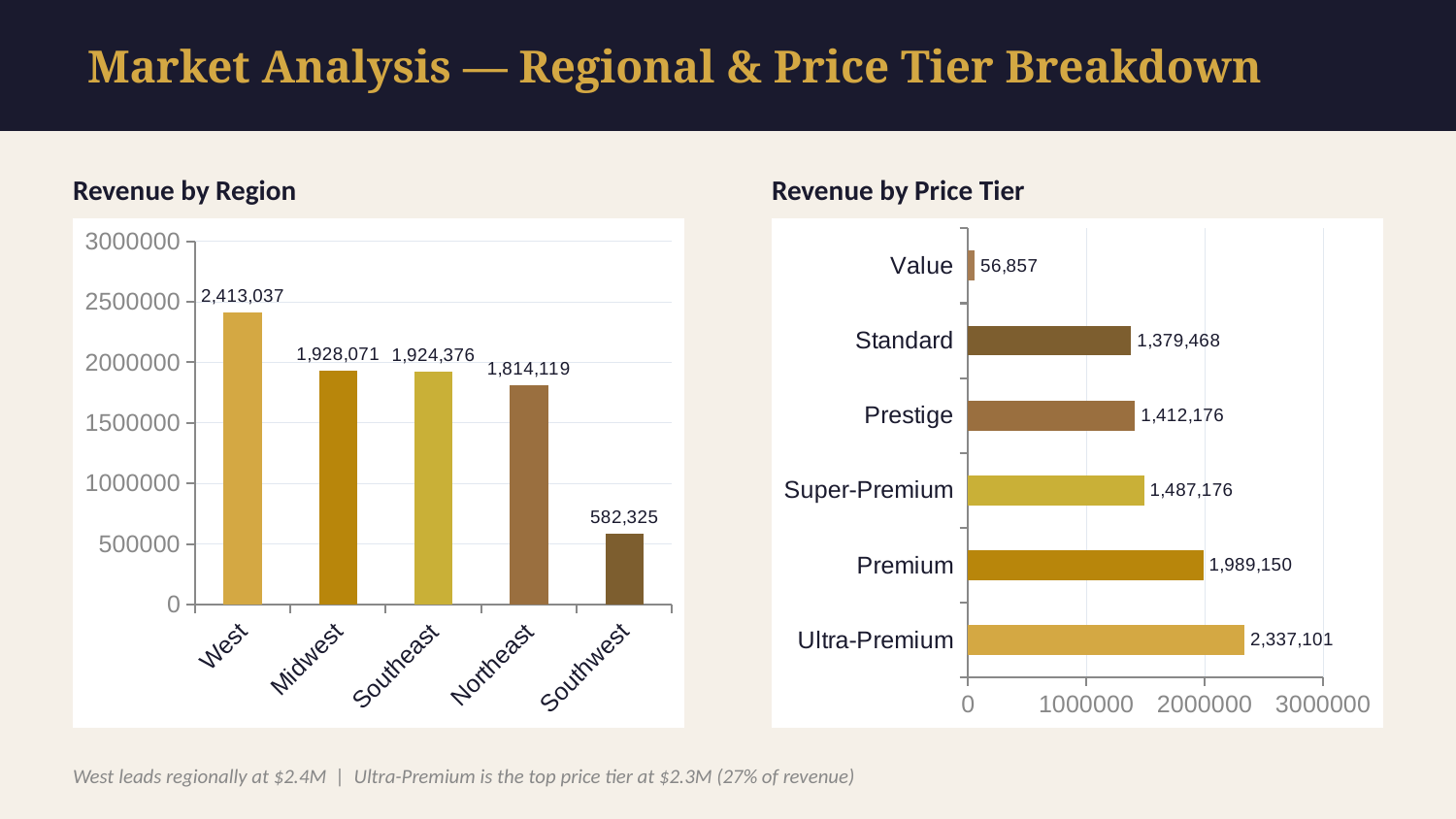
In the Revenue by Price Tier chart, which is larger, Premium or Super-Premium? Premium In the Revenue by Price Tier chart, what is the value for Standard? 1,379,468 What kind of chart is the Revenue by Price Tier chart? bar chart In the Revenue by Price Tier chart, how many price tiers are shown? 6 In the Revenue by Region chart, is the value for Northeast greater or less than 2000000? less In the Revenue by Region chart, what is the difference between West and Southwest? 1,830,712 In the Revenue by Price Tier chart, what is the difference between Ultra-Premium and Premium? 347,951 In the Revenue by Price Tier chart, which price tier has the highest revenue? Ultra-Premium In the Revenue by Price Tier chart, is the value for Value greater or less than 1000000? less In the Revenue by Region chart, which region has the lowest revenue? Southwest In the Revenue by Region chart, what is the value for West? 2,413,037 In the Revenue by Region chart, how many regions are shown? 5